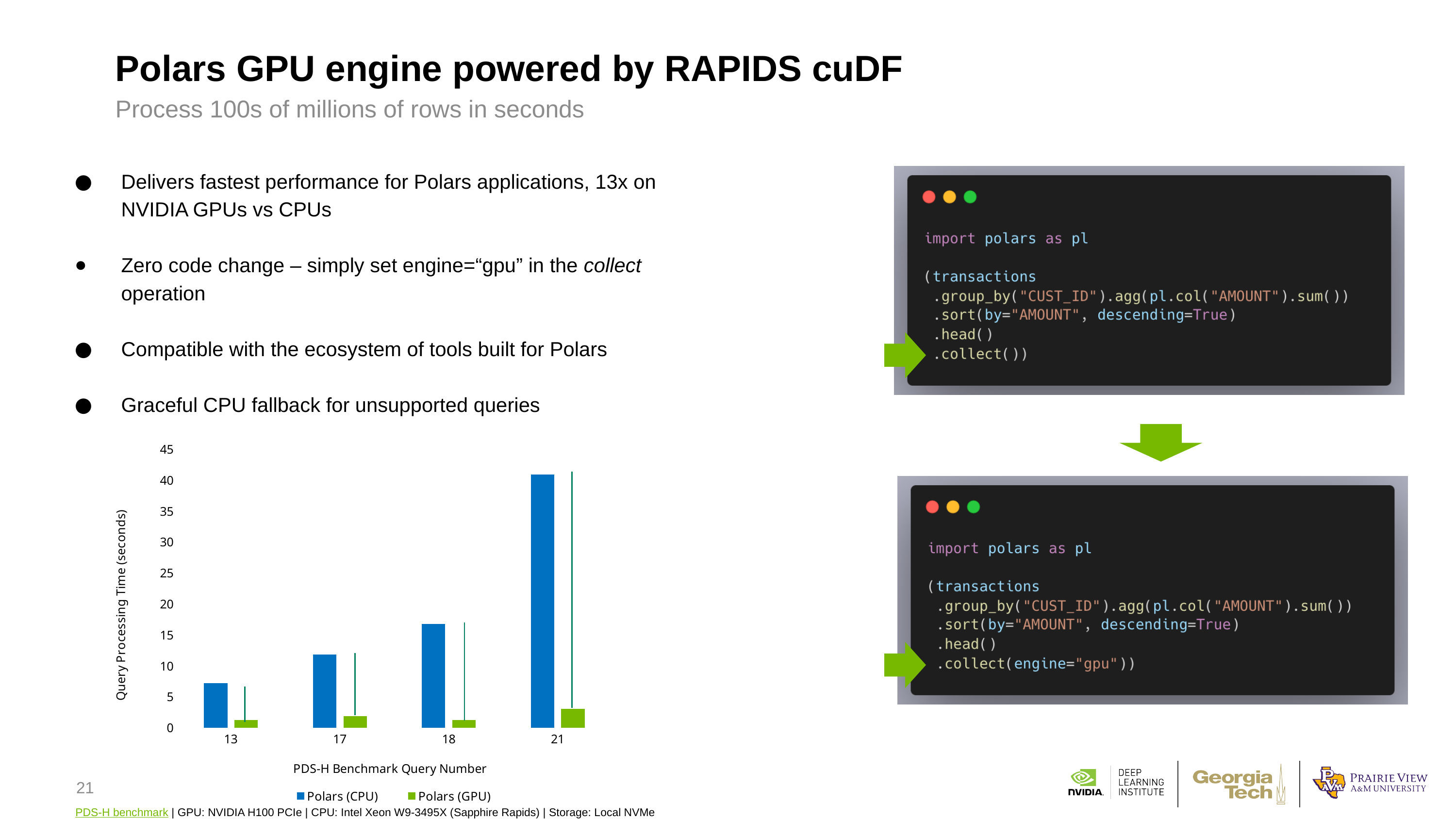
What is the title of the chart's y axis? Query Processing Time (seconds) Which query number has the highest Polars (CPU) query processing time? 21 Is the Polars (CPU) value for query 13 greater or less than 10? less Is the Polars (CPU) value for query 21 greater or less than 35? greater How many query numbers are shown on the x axis of the chart? 4 Do the Polars (CPU) values rise or fall moving from query 13 to query 21 along the x axis? rise Which query number has the lowest Polars (CPU) query processing time? 13 How many series does the chart legend list? 2 For query 21, which is larger: the Polars (CPU) time or the Polars (GPU) time? Polars (CPU) Is the Polars (CPU) value for query 18 greater or less than 15? greater What kind of chart is shown on the slide? bar chart